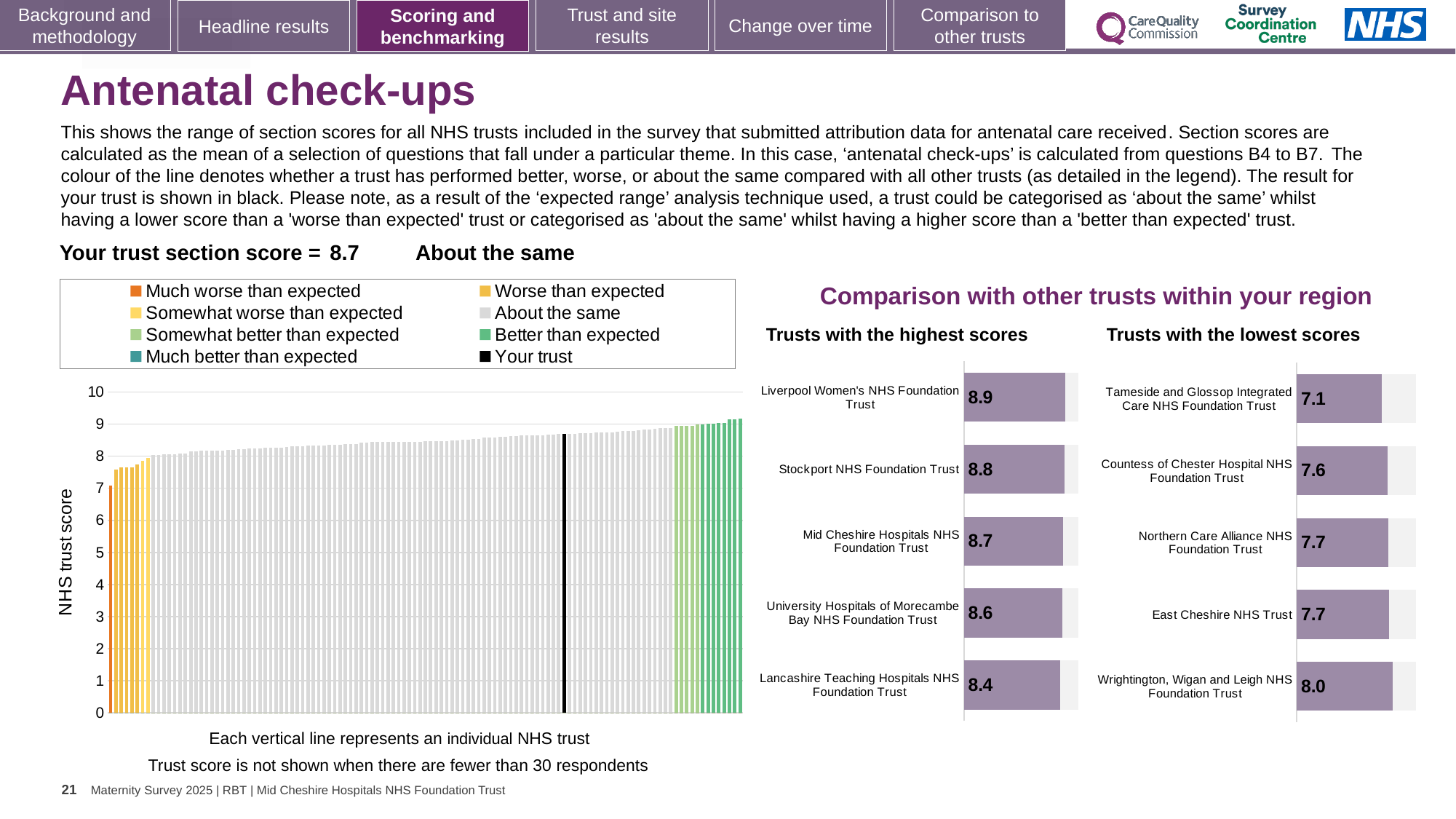
In the 'Trusts with the lowest scores' chart, what is the difference between the scores of Wrightington, Wigan and Leigh NHS Foundation Trust and Tameside and Glossop Integrated Care NHS Foundation Trust? 0.9 What kind of chart is the main chart on the left showing NHS trust scores? Bar chart In the 'Trusts with the highest scores' chart, which trust has the highest score? Liverpool Women's NHS Foundation Trust In the 'Trusts with the lowest scores' chart, which has the higher score: Countess of Chester Hospital NHS Foundation Trust or Wrightington, Wigan and Leigh NHS Foundation Trust? Wrightington, Wigan and Leigh NHS Foundation Trust In the main chart on the left, is the value for the black 'Your trust' bar greater or less than 8? greater In the 'Trusts with the highest scores' chart, what is the score for Liverpool Women's NHS Foundation Trust? 8.9 In the 'Trusts with the lowest scores' chart, which trust has the lowest score? Tameside and Glossop Integrated Care NHS Foundation Trust How many trusts are shown in the 'Trusts with the highest scores' chart? 5 In the 'Trusts with the lowest scores' chart, what is the score for Tameside and Glossop Integrated Care NHS Foundation Trust? 7.1 In the 'Trusts with the highest scores' chart, what is the score for Mid Cheshire Hospitals NHS Foundation Trust? 8.7 How many entries does the legend of the main chart on the left list? 8 In the 'Trusts with the highest scores' chart, what is the difference between the scores of Liverpool Women's NHS Foundation Trust and Lancashire Teaching Hospitals NHS Foundation Trust? 0.5